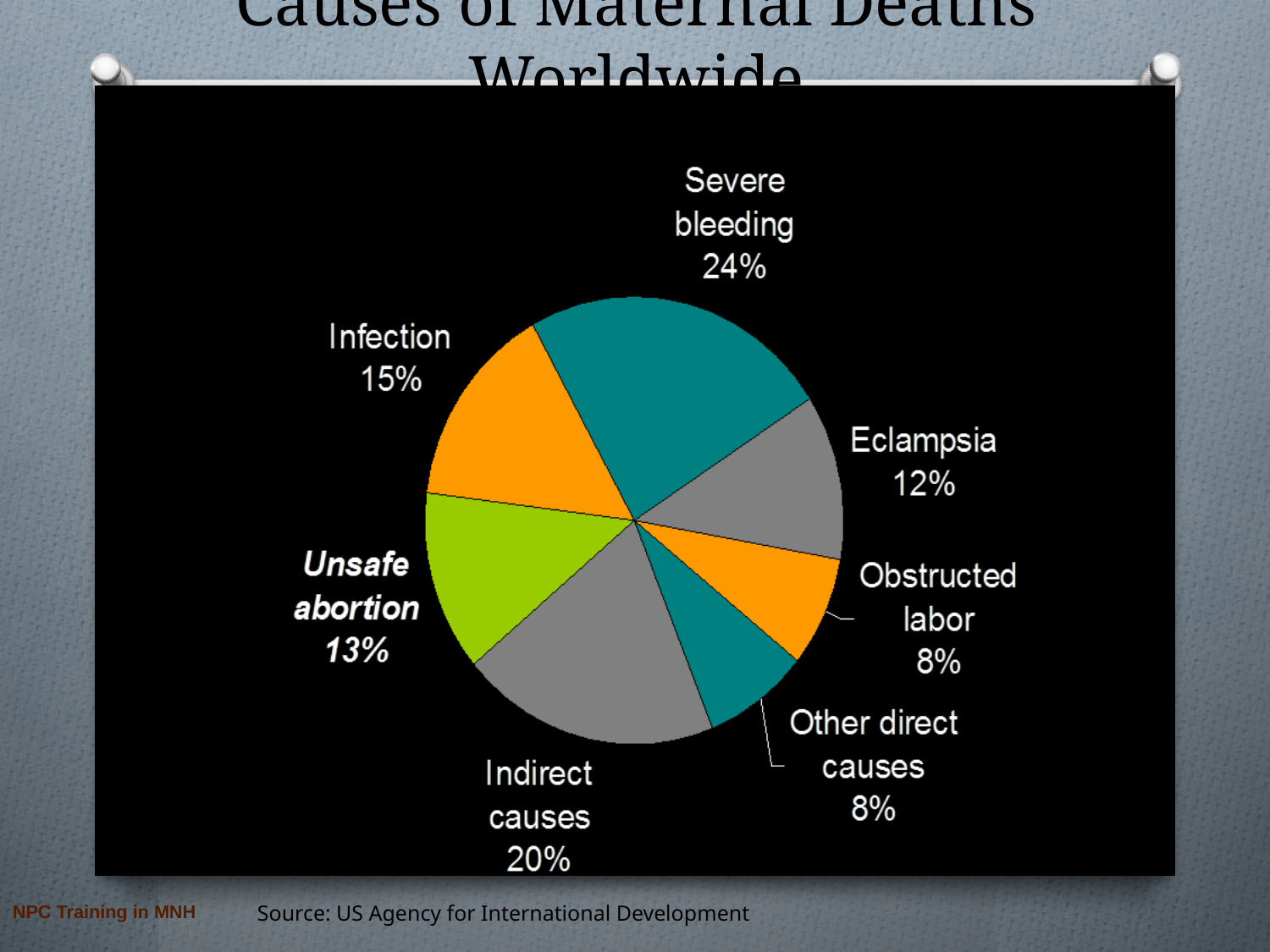
Which cause has the largest slice of the pie? Severe bleeding What percentage of the pie is labelled Infection? 15% What percentage is given for indirect causes? 20% What share is shown for unsafe abortion? 13% How many slices does the pie chart have? 7 Which causes share the smallest slice of the pie? Obstructed labor and Other direct causes What type of chart is shown on the slide? Pie chart What share of maternal deaths is attributed to severe bleeding? 24% What is the difference in percentage points between severe bleeding and eclampsia? 12 Which is larger, the share for infection or the share for unsafe abortion? Infection What is the combined share of severe bleeding and indirect causes? 44% What source is cited for the chart? US Agency for International Development